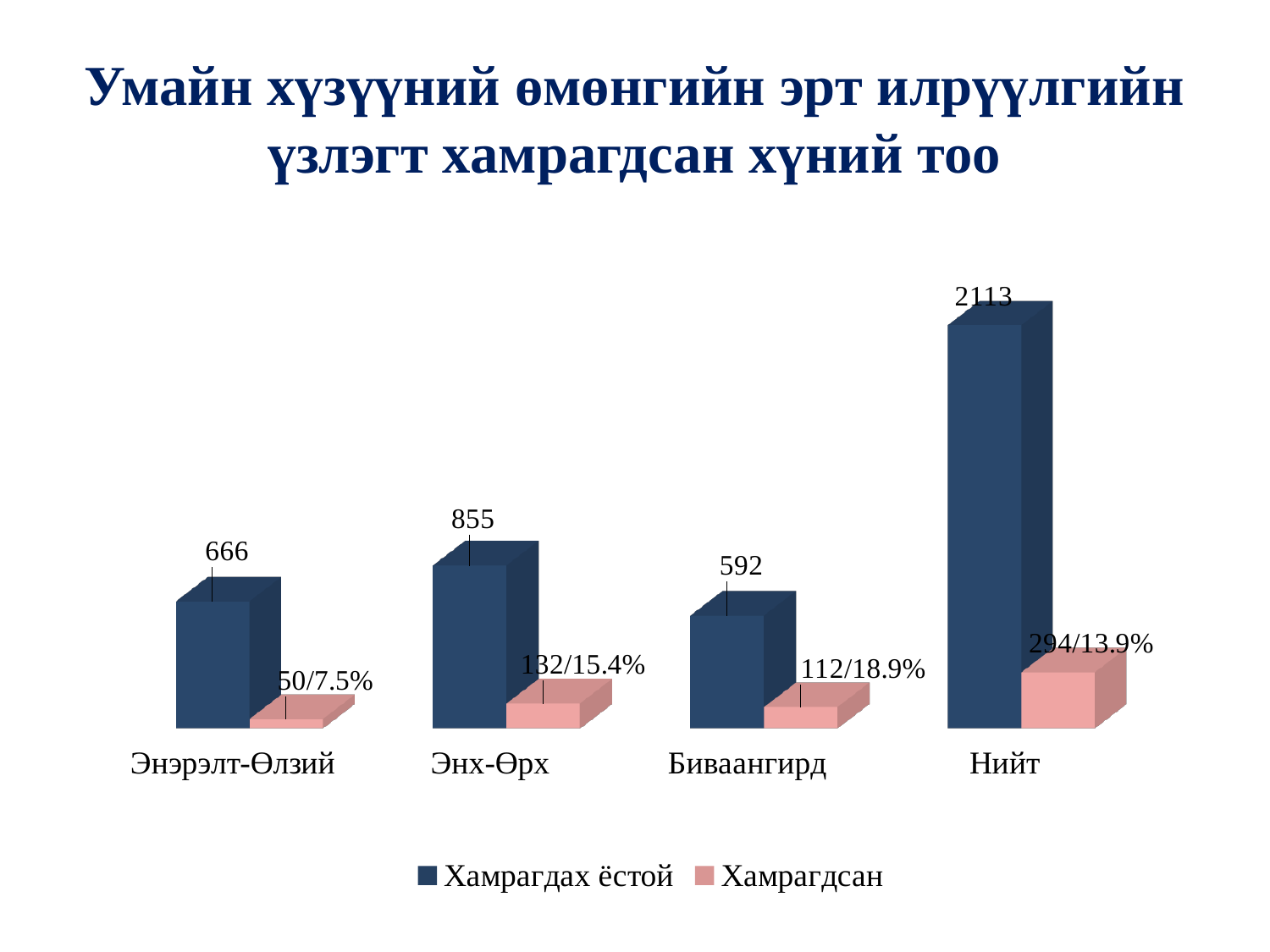
What is the value of Хамрагдах ёстой for Энх-Өрх? 855 Which is larger, the Хамрагдах ёстой value for Энэрэлт-Өлзий or for Биваангирд? Энэрэлт-Өлзий Which category has the highest Хамрагдах ёстой value? Нийт What is the data label for Хамрагдсан for Нийт? 294/13.9% How many series does the legend list? 2 What is the value of Хамрагдах ёстой for Нийт? 2113 Which category has the lowest Хамрагдах ёстой value? Биваангирд What kind of chart is shown on the slide? Bar chart What is the difference between the Хамрагдах ёстой values for Энх-Өрх and Энэрэлт-Өлзий? 189 How many categories are shown on the x axis? 4 What is the data label for Хамрагдсан for Биваангирд? 112/18.9% What are the two series named in the legend? Хамрагдах ёстой and Хамрагдсан